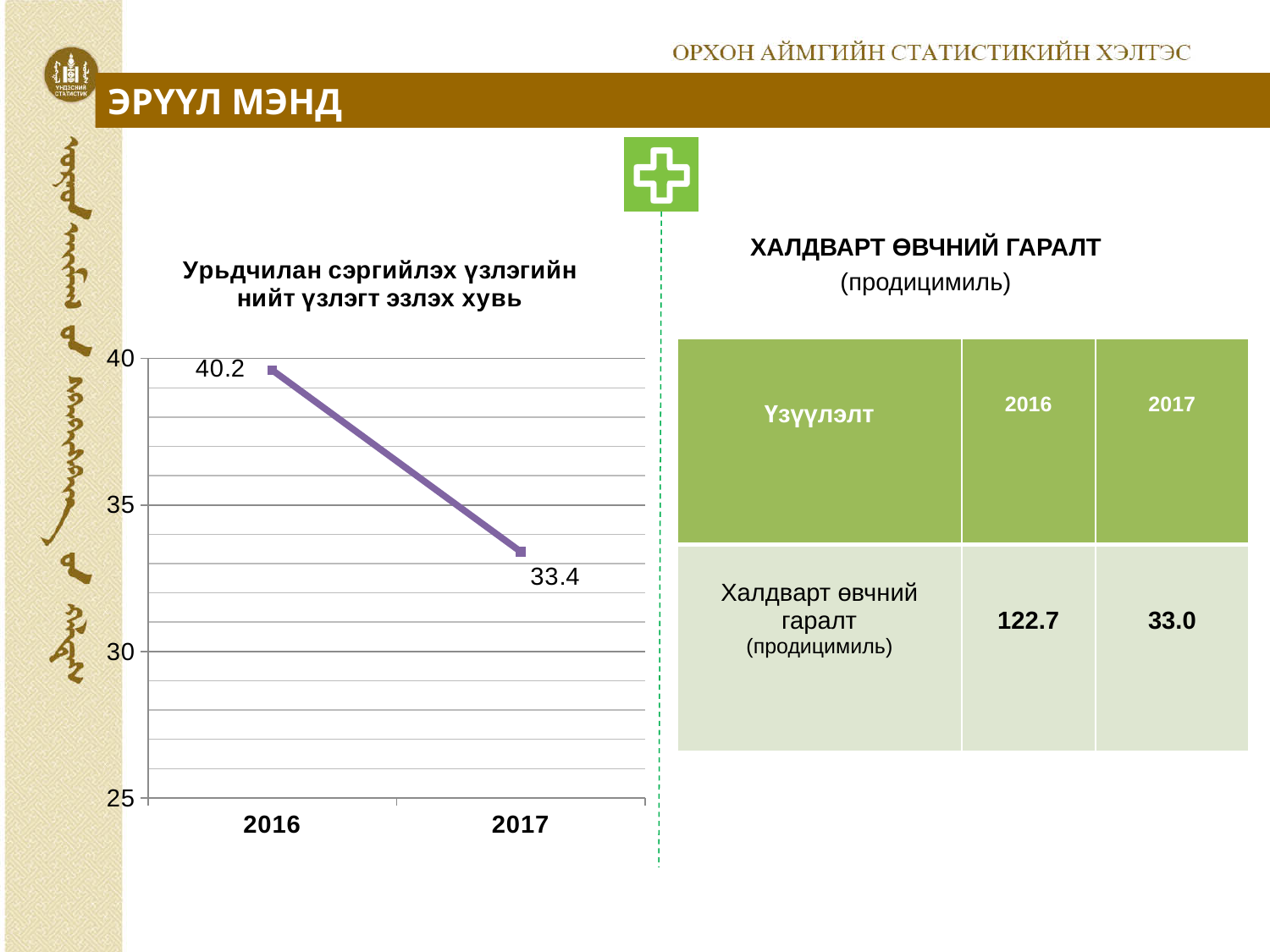
Do the values in the line chart rise or fall from 2016 to 2017? fall What is the title of the line chart? Урьдчилан сэргийлэх үзлэгийн нийт үзлэгт эзлэх хувь Is the value for 2016 in the line chart greater or less than 35? greater Which year has the lowest value in the line chart? 2017 What is the value for 2017 in the line chart? 33.4 What is the value for 2016 in the line chart? 40.2 Is the value for 2017 in the line chart greater or less than 35? less Which year has the highest value in the line chart? 2016 Which is larger in the line chart, the value for 2016 or the value for 2017? 2016 What is the difference between the 2016 and 2017 values in the line chart? 6.8 What kind of chart is shown on the slide? line chart How many data points are plotted in the line chart? 2